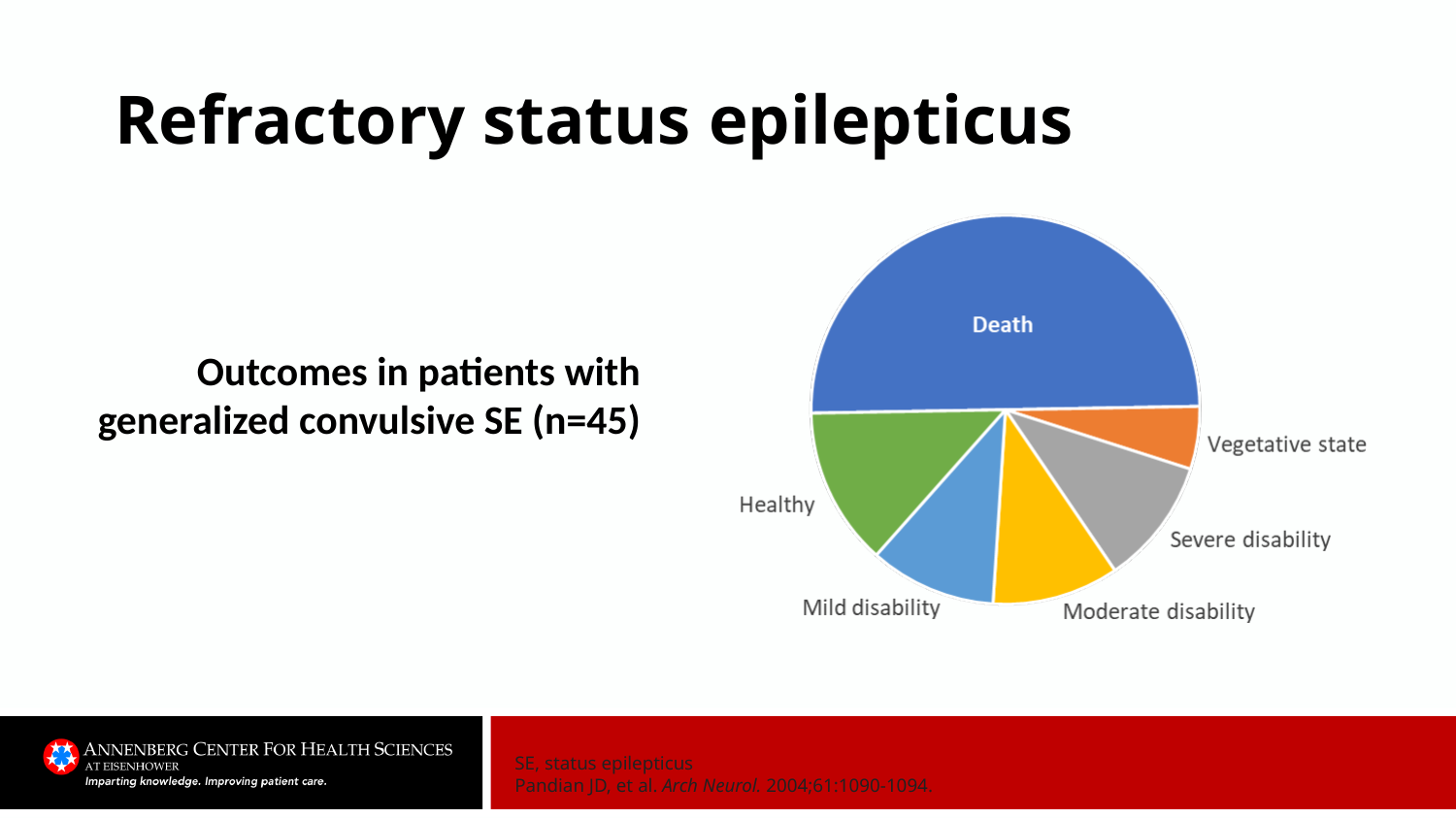
Which slice is larger, Healthy or Mild disability? Healthy Which slice is larger, Moderate disability or Vegetative state? Moderate disability What colour is the Death slice of the pie chart? Blue How many outcome categories does the pie chart show? 6 What kind of chart is shown on the slide? Pie chart Which slice is larger, Death or Healthy? Death What is the caption describing the pie chart's data? Outcomes in patients with generalized convulsive SE (n=45) Which outcome category has the smallest slice of the pie chart? Vegetative state Which outcome category has the largest slice of the pie chart? Death